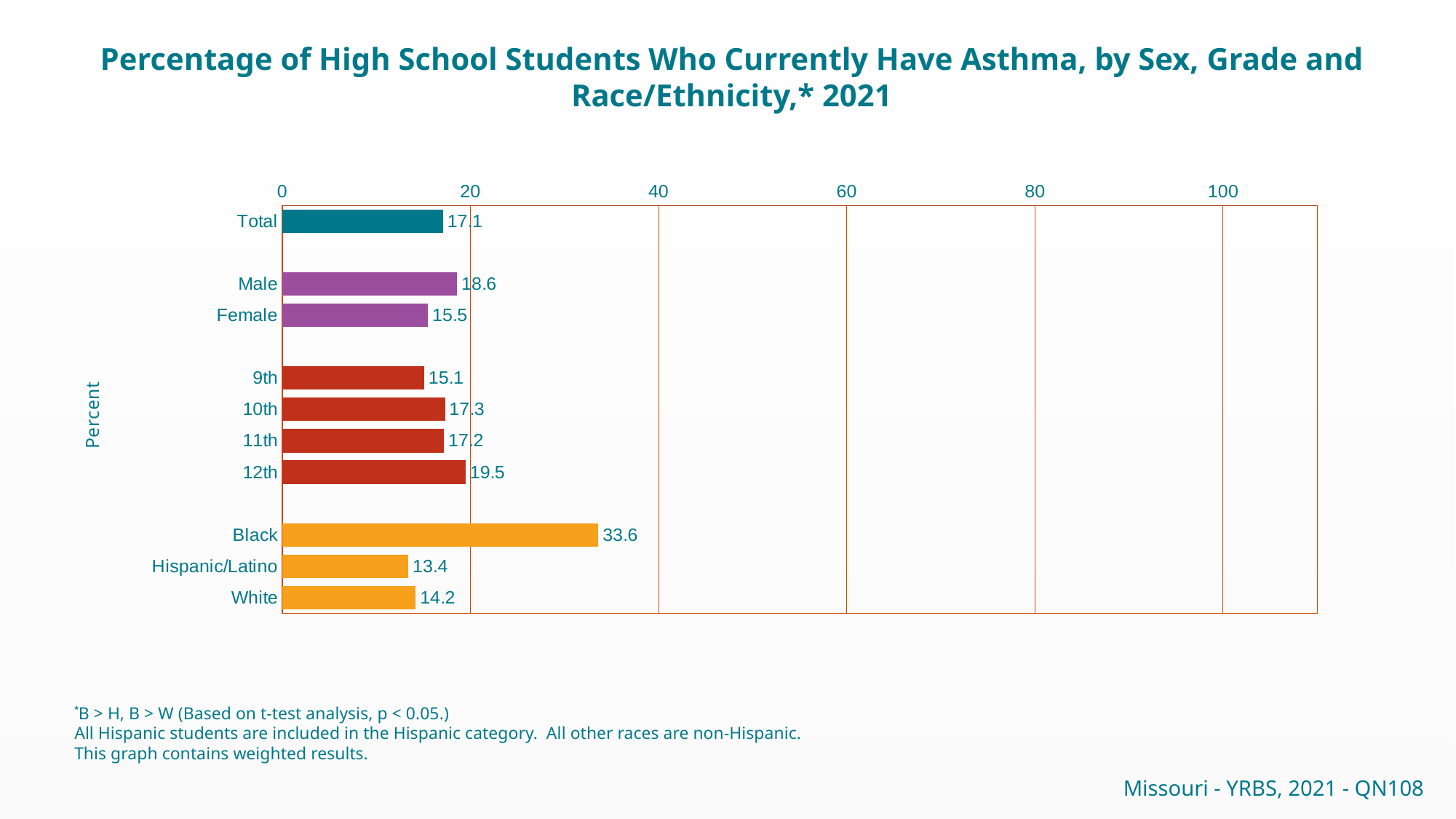
Which category has the lowest value? Hispanic/Latino What is the value for Black students? 33.6 Is the value for Black greater or less than 20? greater What is the difference between the Male and Female values? 3.1 Which category has the highest value? Black What is the label on the vertical axis? Percent How many categories are shown in the chart? 11 What kind of chart is shown on the slide? bar chart What is the difference between the Black and White values? 19.4 What is the value for 12th grade? 19.5 Which is larger, the value for 9th grade or 12th grade? 12th What is the value for Total? 17.1